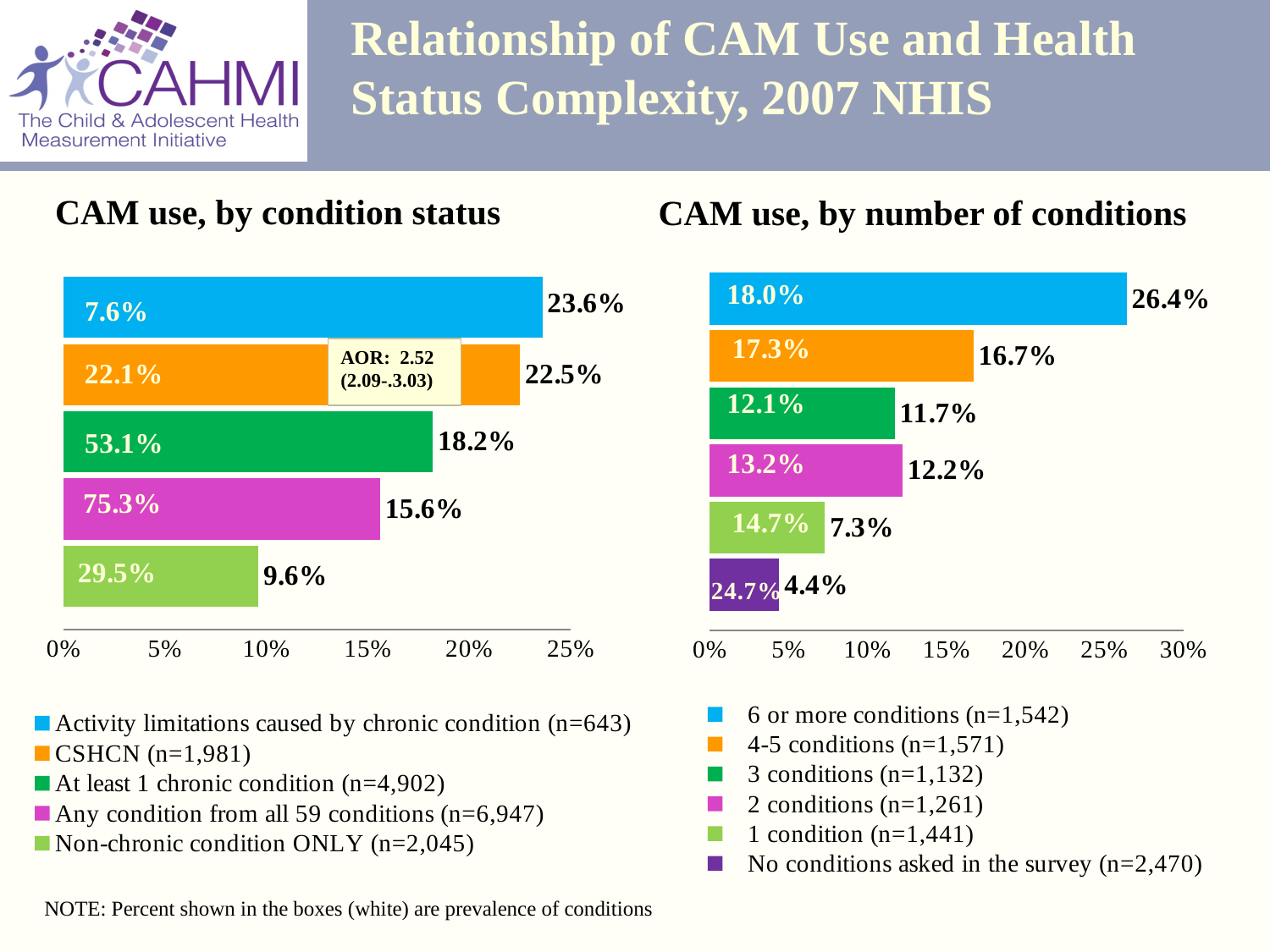
In the 'CAM use, by condition status' chart, what prevalence percentage is shown in the white box for 'Any condition from all 59 conditions'? 75.3% In the 'CAM use, by condition status' chart, which category has the highest CAM use? Activity limitations caused by chronic condition In the 'CAM use, by number of conditions' chart, which category has the lowest CAM use? No conditions asked in the survey What type of chart is 'CAM use, by condition status'? Bar chart In the 'CAM use, by number of conditions' chart, what is the difference in CAM use between 6 or more conditions and 4-5 conditions? 9.7% In the 'CAM use, by condition status' chart, what is the CAM use value for Non-chronic condition ONLY? 9.6% In the 'CAM use, by condition status' chart, what AOR value is shown in the box on the CSHCN bar? 2.52 In the 'CAM use, by number of conditions' chart, what is the CAM use value for 6 or more conditions? 26.4% In the 'CAM use, by number of conditions' chart, which is larger: CAM use for 3 conditions or for 2 conditions? 2 conditions How many categories are shown in the 'CAM use, by number of conditions' chart? 6 In the 'CAM use, by condition status' chart, what is the difference in CAM use between 'At least 1 chronic condition' and 'Any condition from all 59 conditions'? 2.6% In the 'CAM use, by condition status' chart, what is the CAM use value for CSHCN? 22.5%